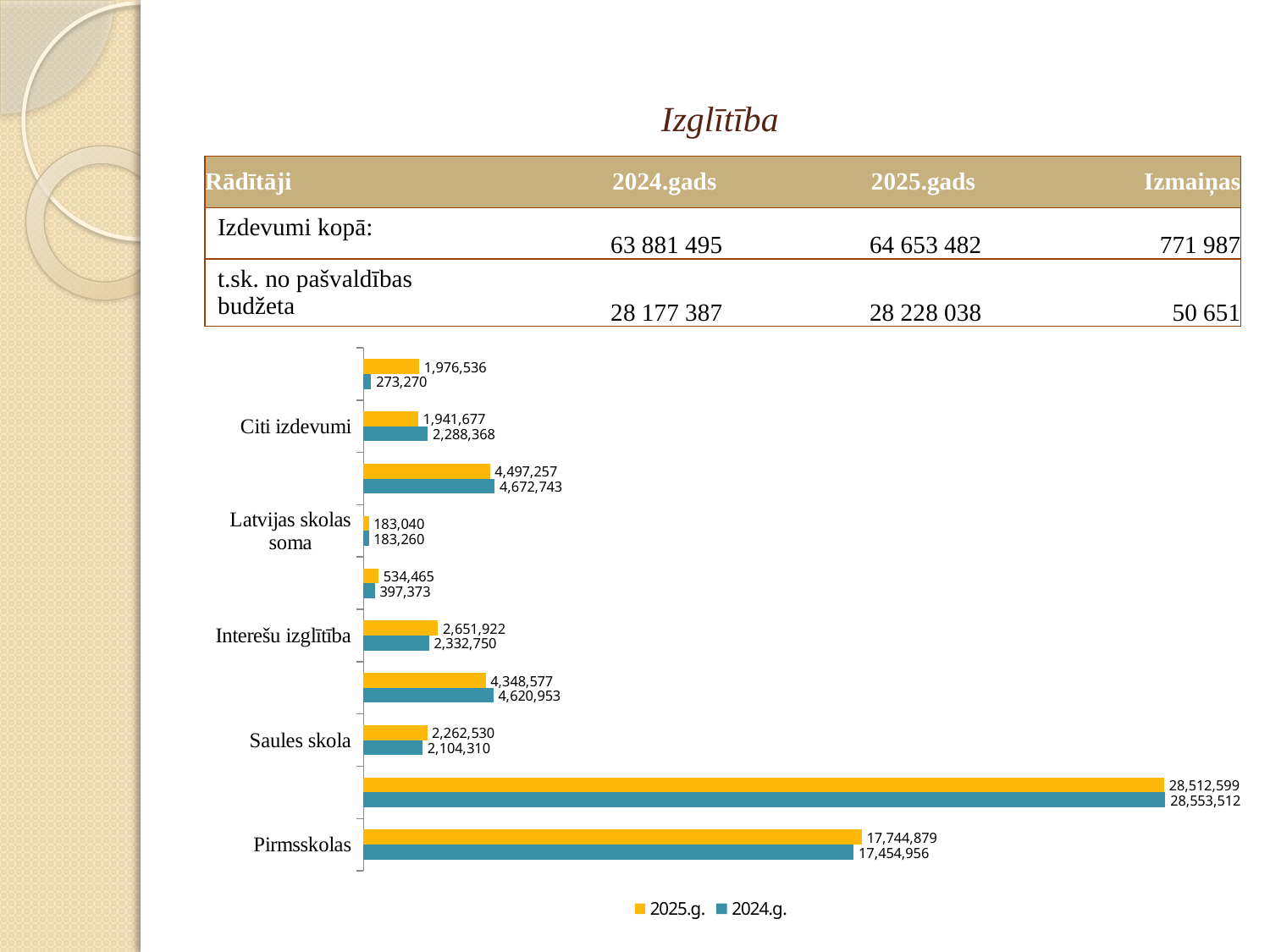
Which colour represents the 2024.g. series in the chart? Teal (blue-green) What is the 2025.g. value for Citi izdevumi? 1,941,677 What is the 2025.g. value for Interešu izglītība? 2,651,922 What kind of chart is shown on the slide? Bar chart What is the 2024.g. value for Latvijas skolas soma? 183,260 For Citi izdevumi, which is larger: the 2024.g. value or the 2025.g. value? 2024.g. What is the 2024.g. value for Saules skola? 2,104,310 How many series does the chart legend list? 2 What is the difference between the 2025.g. and 2024.g. values for Pirmsskolas? 289,923 Among the labelled categories, which has the highest 2025.g. value? Pirmsskolas Among the labelled categories, which has the lowest 2024.g. value? Latvijas skolas soma What is the 2025.g. value for Pirmsskolas? 17,744,879